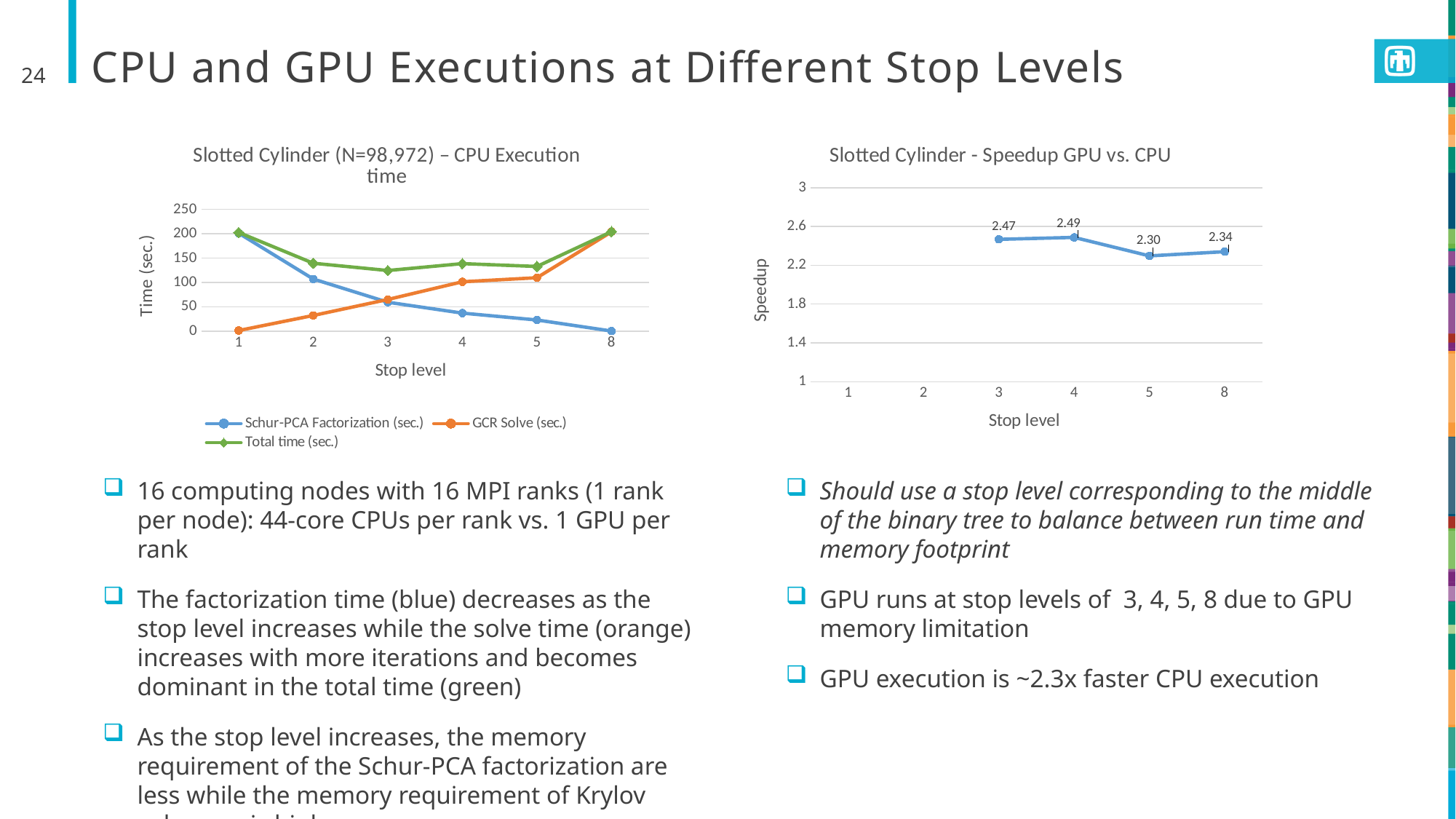
In the 'Slotted Cylinder - Speedup GPU vs. CPU' chart, is the speedup at stop level 3 larger or smaller than at stop level 8? larger In the 'Slotted Cylinder (N=98,972) – CPU Execution time' chart, how many series does the legend list? 3 In the 'Slotted Cylinder - Speedup GPU vs. CPU' chart, which stop level has the lowest speedup? 5 In the 'Slotted Cylinder (N=98,972) – CPU Execution time' chart, is the GCR Solve time at stop level 2 greater or less than 50? less In the 'Slotted Cylinder - Speedup GPU vs. CPU' chart, what is the speedup at stop level 5? 2.30 In the 'Slotted Cylinder - Speedup GPU vs. CPU' chart, what is the difference between the speedup at stop level 4 and at stop level 5? 0.19 In the 'Slotted Cylinder - Speedup GPU vs. CPU' chart, which stop level has the highest speedup? 4 In the 'Slotted Cylinder (N=98,972) – CPU Execution time' chart, does the Schur-PCA Factorization time rise or fall as the stop level increases? fall In the 'Slotted Cylinder - Speedup GPU vs. CPU' chart, what is the speedup at stop level 4? 2.49 In the 'Slotted Cylinder - Speedup GPU vs. CPU' chart, how many data points are plotted? 4 What kind of chart is the 'Slotted Cylinder (N=98,972) – CPU Execution time' chart? line chart In the 'Slotted Cylinder (N=98,972) – CPU Execution time' chart, is the Schur-PCA Factorization time at stop level 1 greater or less than 150? greater